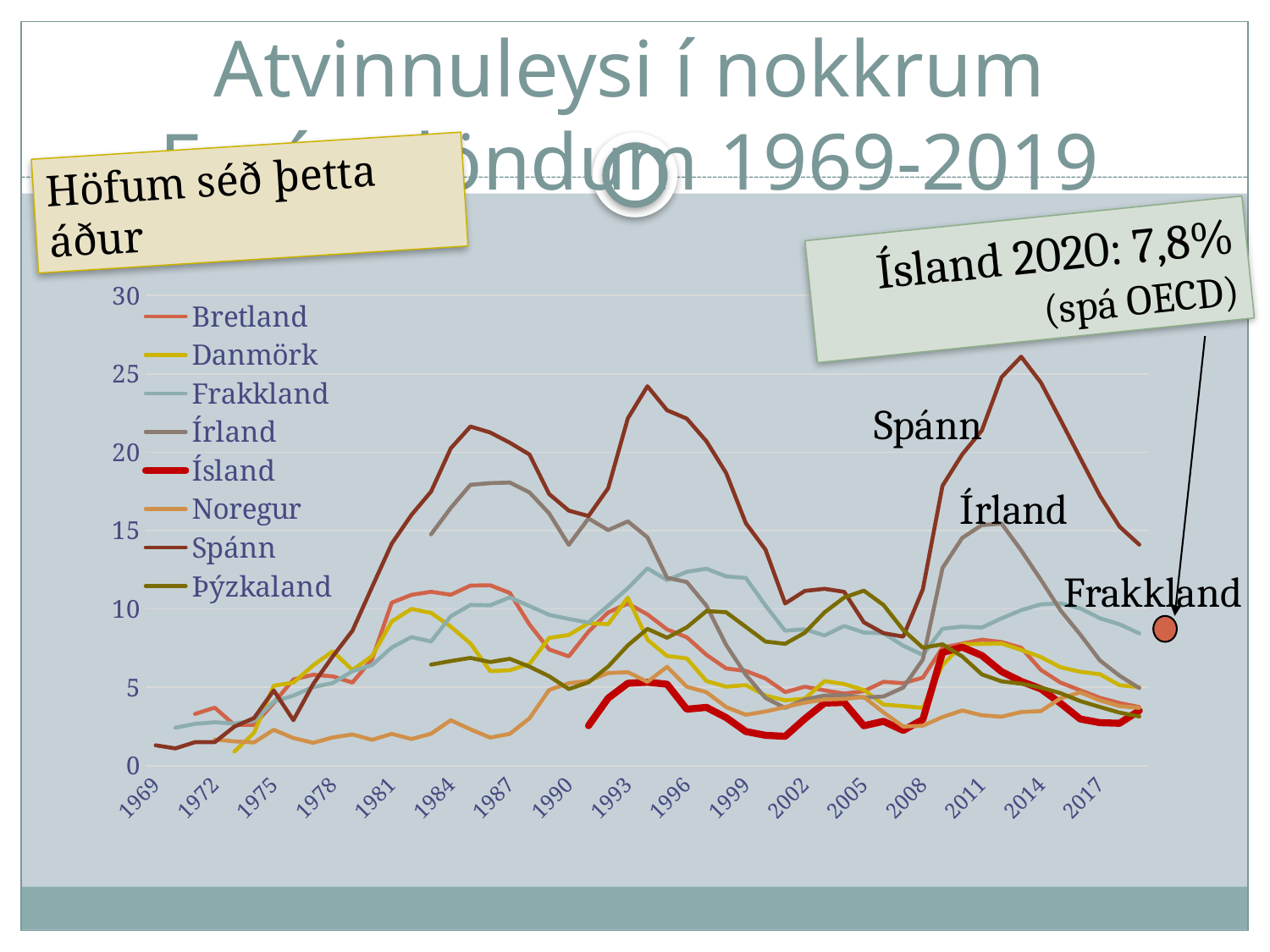
Which series is drawn with the thick red line? Ísland Does the line for Spánn rise or fall between 2013 and 2019? fall Is the value for Ísland in 2010 greater or less than 5? greater What kind of chart is shown on the slide? line chart Is the value for Frakkland in 2019 greater or less than 10? less Which country's line reaches the highest value on the chart? Spánn Is the value for Spánn around 2013 greater or less than 25? greater What forecast value for Ísland in 2020 is given in the callout on the slide? 7,8% How many series does the legend list? 8